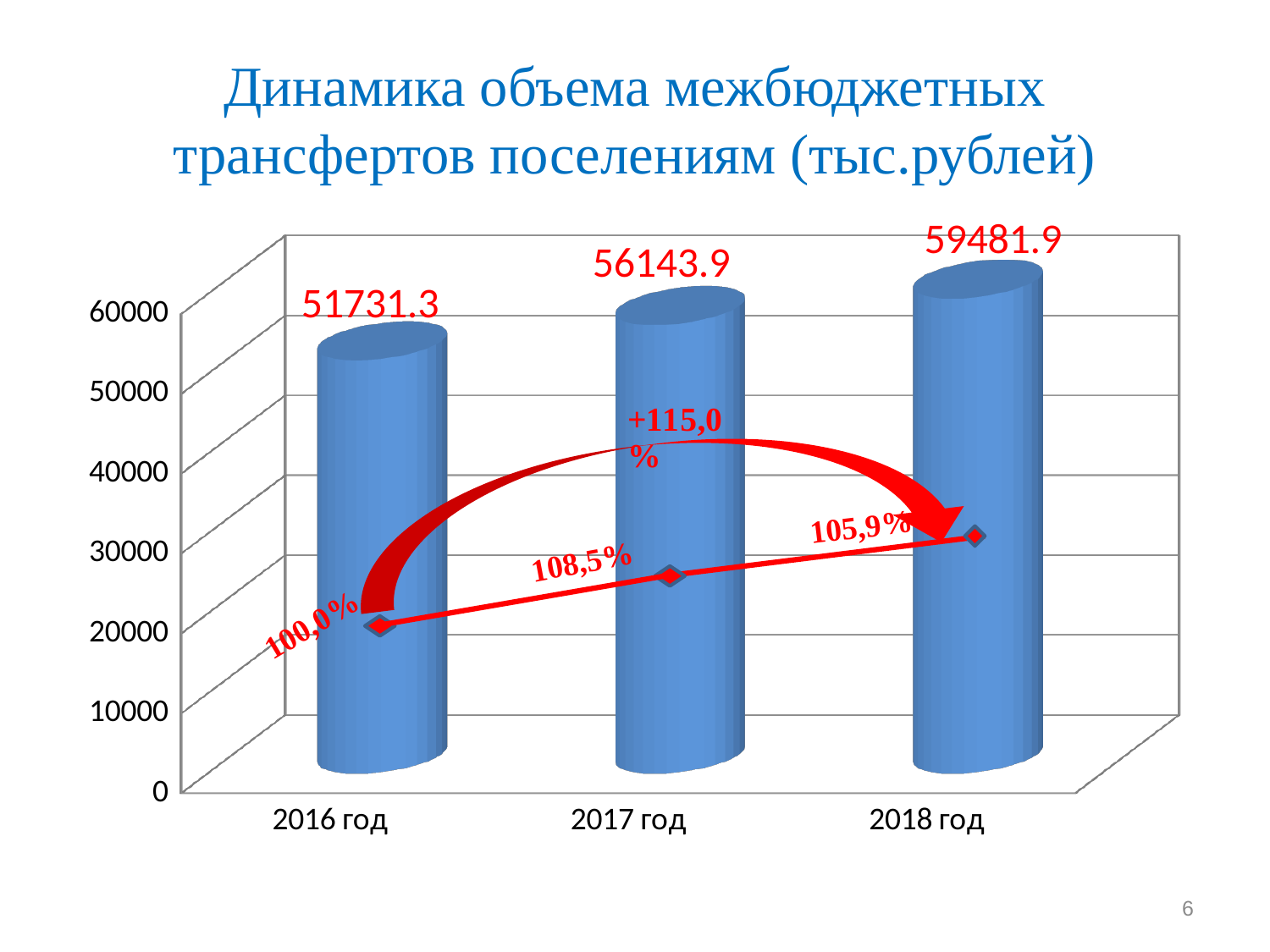
Is the value for 2016 год greater or less than 50000? greater What is the value for 2018 год? 59481.9 What is the difference between the values for 2018 год and 2017 год? 3338.0 Which is larger, the value for 2016 год or the value for 2018 год? 2018 год What is the value for 2017 год? 56143.9 What is the difference between the values for 2017 год and 2016 год? 4412.6 Which year has the highest value? 2018 год What kind of chart is this? bar chart Which year has the lowest value? 2016 год How many years are shown on the x axis? 3 Do the values rise or fall from 2016 год to 2018 год? rise What is the value for 2016 год? 51731.3